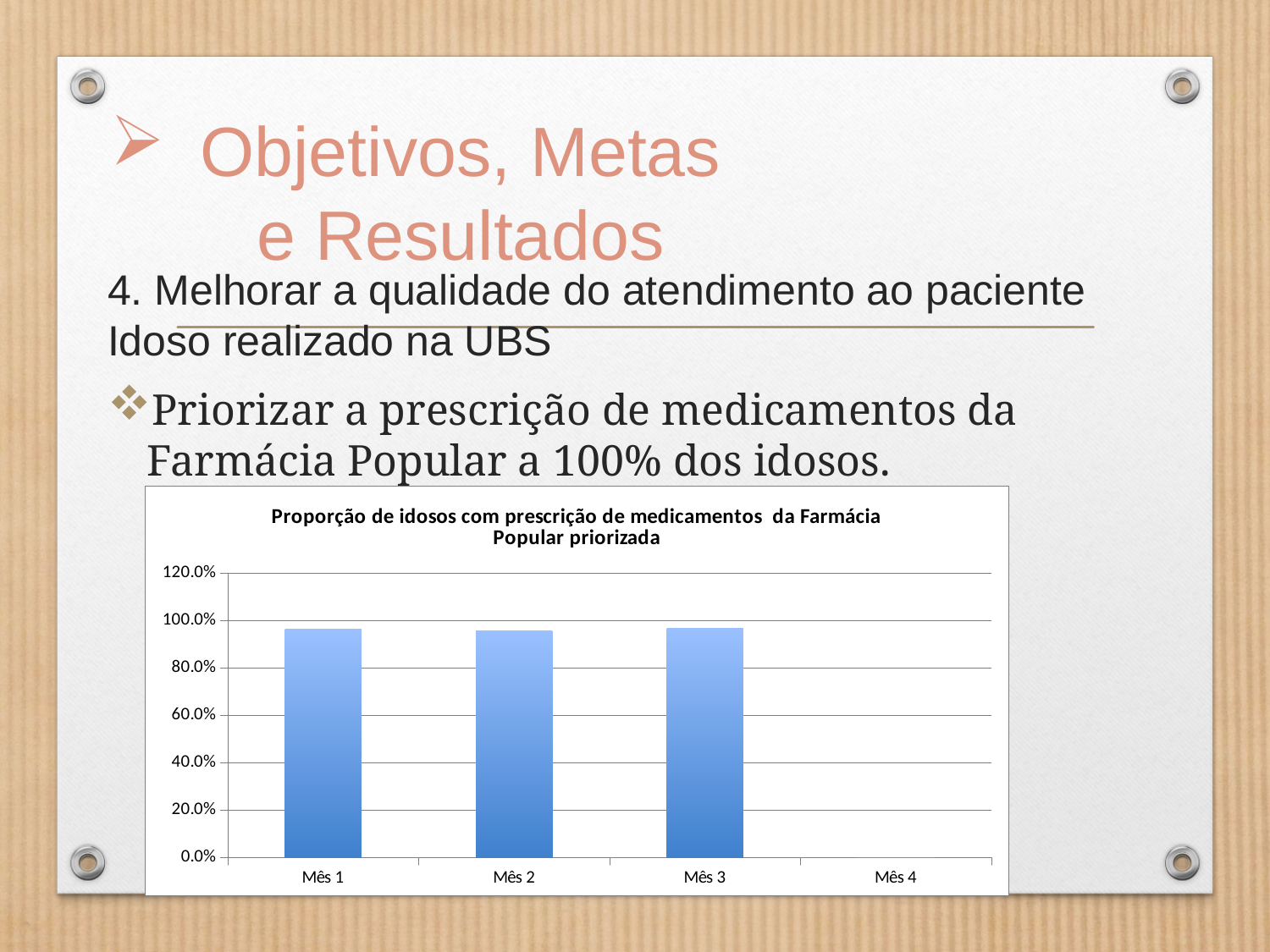
How many categories are shown on the x axis of the chart? 4 What is the title of the chart? Proporção de idosos com prescrição de medicamentos da Farmácia Popular priorizada How many bars are visibly plotted in the chart? 3 Is the value for Mês 2 greater or less than 100.0%? less Is the value for Mês 3 greater or less than 60.0%? greater Which category has the lowest value in the chart? Mês 4 Which is larger, the value for Mês 1 or the value for Mês 4? Mês 1 Is the value for Mês 1 greater or less than 80.0%? greater What is the highest tick value shown on the y axis? 120.0% What kind of chart is shown on the slide? bar chart